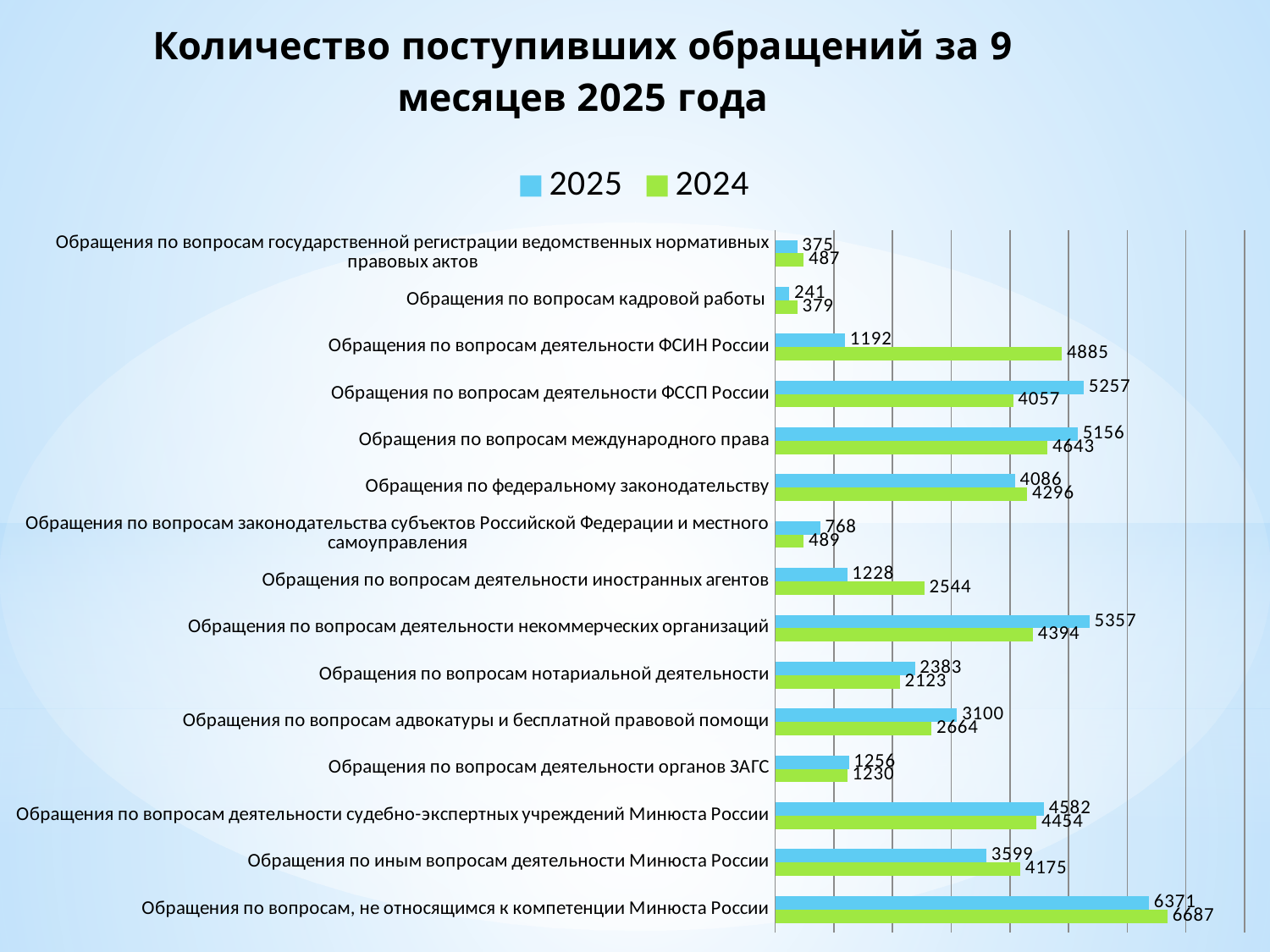
What is the 2024 value for 'Обращения по вопросам деятельности иностранных агентов'? 2544 What is the 2025 value for 'Обращения по вопросам деятельности ФСИН России'? 1192 Which colour represents the 2024 series in the chart? Green Which category has the highest 2025 value? Обращения по вопросам, не относящимся к компетенции Минюста России What type of chart is shown on the slide? Bar chart How many series does the legend list? 2 For 'Обращения по иным вопросам деятельности Минюста России', which year has the larger value, 2025 or 2024? 2024 What is the 2025 value for 'Обращения по вопросам нотариальной деятельности'? 2383 How many categories are shown in the chart? 15 What is the difference between the 2024 and 2025 values for 'Обращения по вопросам деятельности ФСИН России'? 3693 What is the difference between the 2025 and 2024 values for 'Обращения по вопросам деятельности ФССП России'? 1200 Which category has the lowest 2025 value? Обращения по вопросам кадровой работы